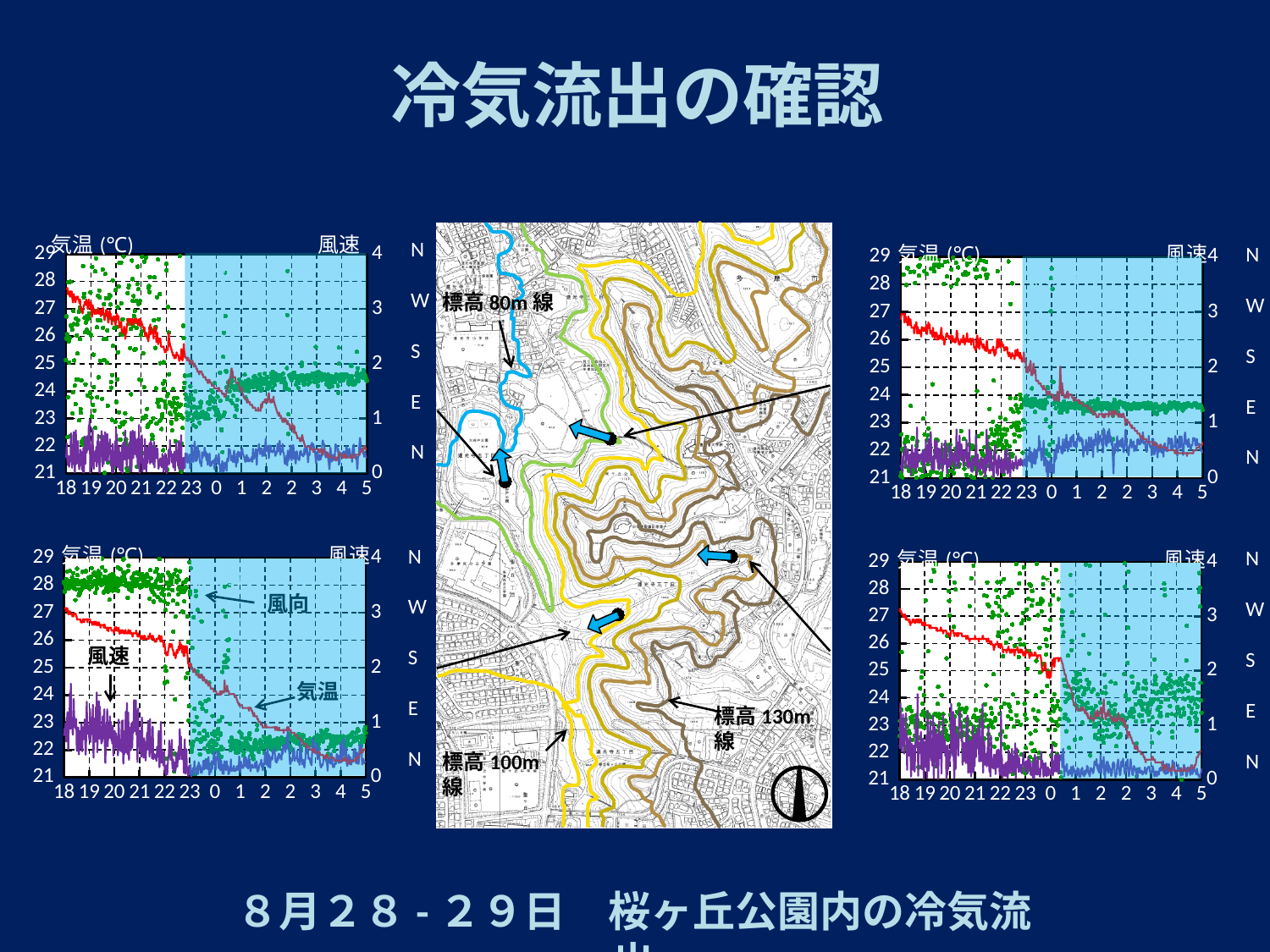
In the top-right chart, is the temperature at 5 greater or less than 24? less In the top-right chart, does the temperature (red line) rise or fall over the time shown? fall What kind of chart is the top-left chart on the slide? line chart Which three series labels are annotated on the bottom-left chart? 風向, 風速, 気温 What is the label of the left vertical axis on the top-left chart? 気温 (°C) In the top-left chart, does the temperature (red line) rise or fall from 18 to 5 along the x axis? fall In the top-left chart, is the temperature at 18 greater or less than 26? greater In the bottom-right chart, is the temperature at 18 greater or less than 26? greater How many charts (excluding the map) are shown on the slide? 4 How many tick labels are shown on the x axis of the top-left chart? 13